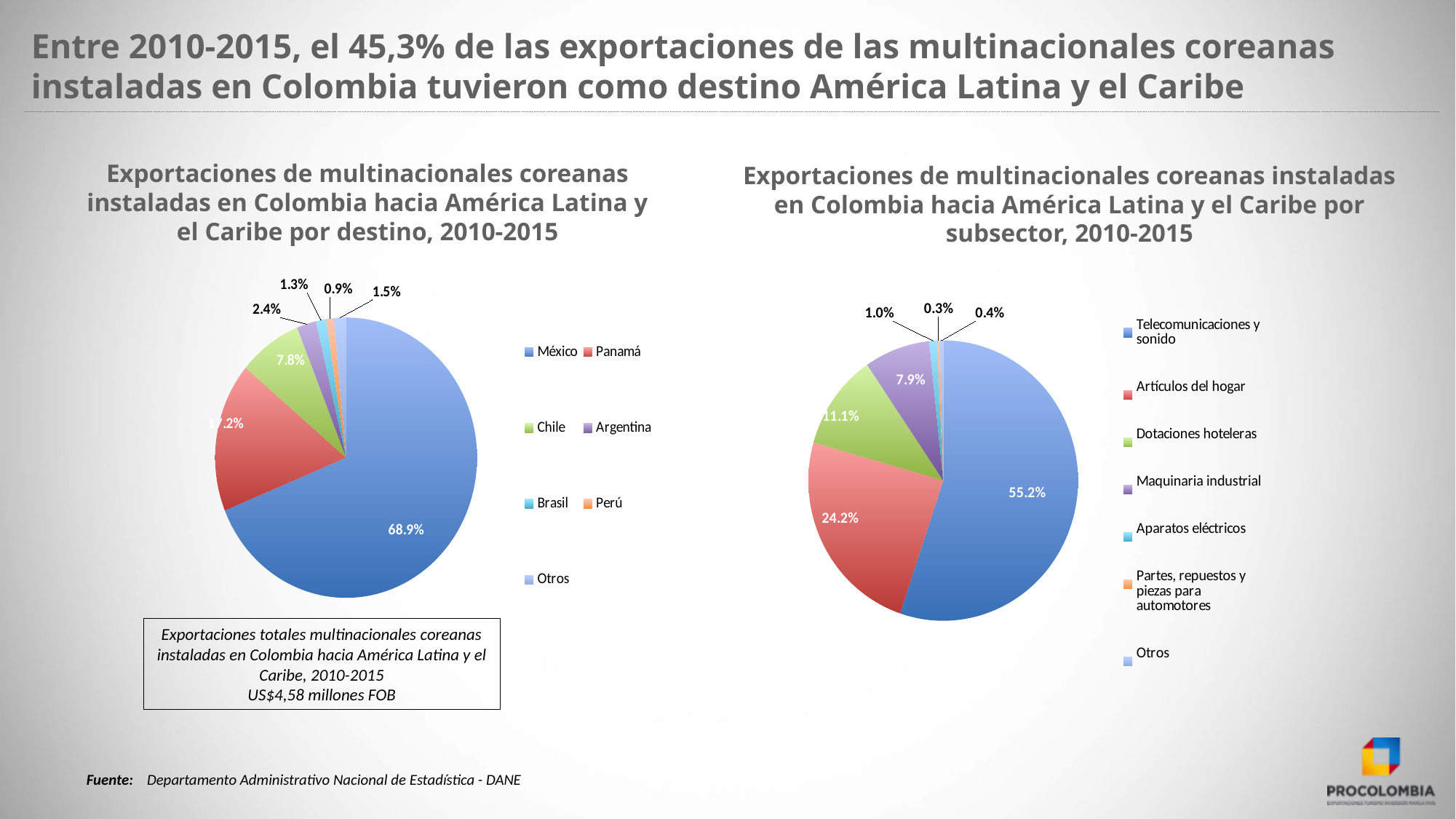
In the left chart (by destino), what share of exports went to Panamá? 17.2% In the right chart (by subsector), what share corresponds to Dotaciones hoteleras? 11.1% In the right chart (by subsector), what is the difference between the shares of Telecomunicaciones y sonido and Artículos del hogar? 31.0% In the right chart (by subsector), which is larger: Maquinaria industrial or Dotaciones hoteleras? Dotaciones hoteleras In the right chart (by subsector), what share corresponds to Artículos del hogar? 24.2% In the left chart (by destino), how many categories does the legend list? 7 In the left chart (by destino), which destination has the smallest share? Perú In the left chart (by destino), which destination has the largest share? México What type of chart is used on the right side of the slide? Pie chart